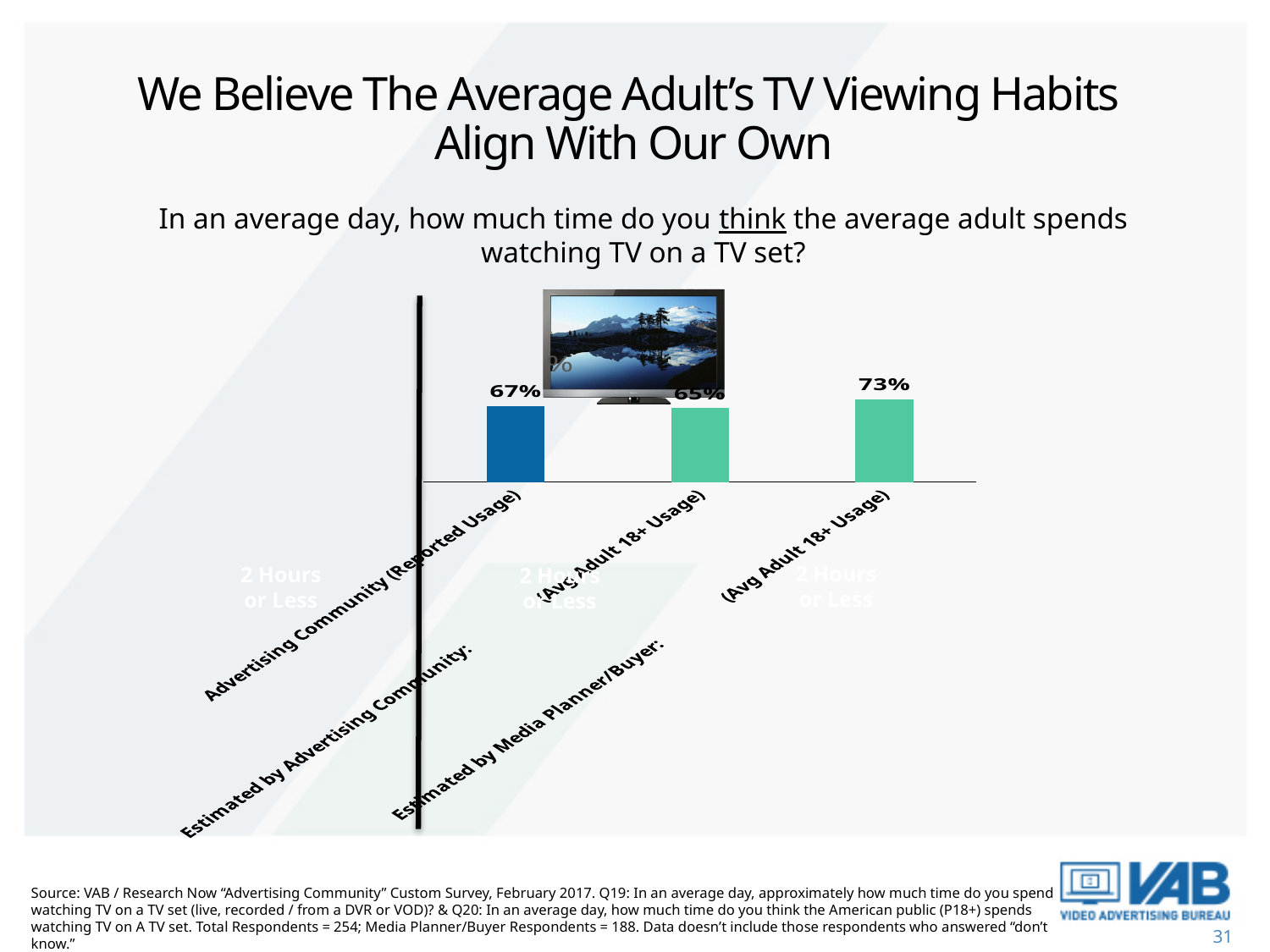
What value is shown for the bar labelled Estimated by Media Planner/Buyer: (Avg Adult 18+ Usage)? 73% What type of chart is shown on the slide? Bar chart What question is the chart answering, according to the text above it? In an average day, how much time do you think the average adult spends watching TV on a TV set? What value is shown for the bar labelled Estimated by Advertising Community: (Avg Adult 18+ Usage)? 65% Which category has the highest value in the chart? Estimated by Media Planner/Buyer: (Avg Adult 18+ Usage) Which category has the lowest value in the chart? Estimated by Advertising Community: (Avg Adult 18+ Usage) Which is larger: the Estimated by Media Planner/Buyer value or the Estimated by Advertising Community value? Estimated by Media Planner/Buyer How many bars are plotted in the chart? 3 What colour is the Advertising Community (Reported Usage) bar? Blue What value is shown for the Advertising Community (Reported Usage) bar? 67% What is the difference between the Advertising Community (Reported Usage) value and the Estimated by Advertising Community value? 2% What is the difference between the Estimated by Media Planner/Buyer value and the Advertising Community (Reported Usage) value? 6%